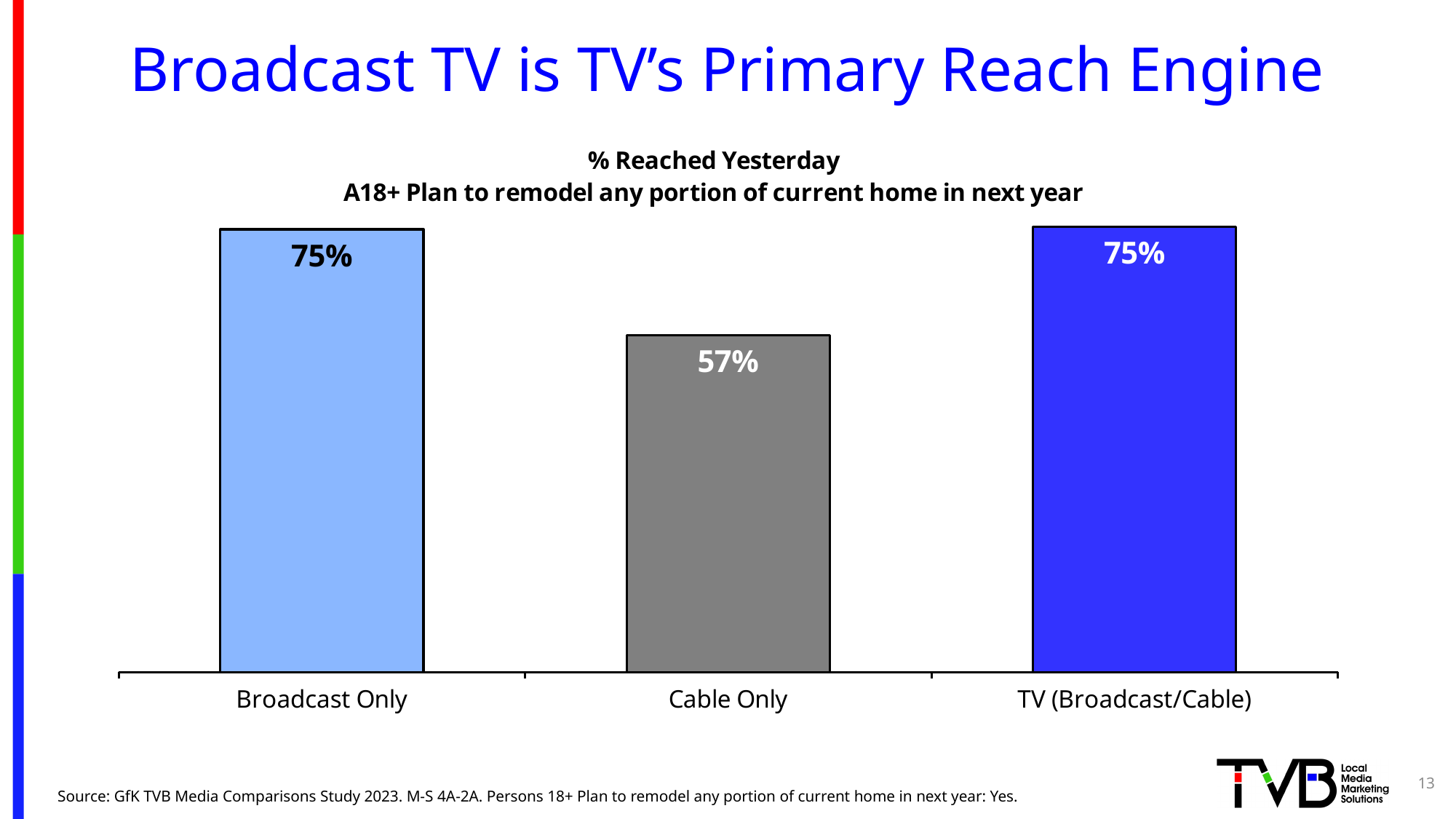
What is the value for Cable Only? 57% Which category has the lowest value? Cable Only What is the value for Broadcast Only? 75% What is the difference between the Broadcast Only and Cable Only values? 18% What is the value for TV (Broadcast/Cable)? 75% What kind of chart is shown on the slide? bar chart What colour is the Cable Only bar? gray What is the first line of the chart's title? % Reached Yesterday How many categories are shown on the chart? 3 Do the Broadcast Only and TV (Broadcast/Cable) bars have the same value? Yes Which is larger, the value for Cable Only or the value for TV (Broadcast/Cable)? TV (Broadcast/Cable)